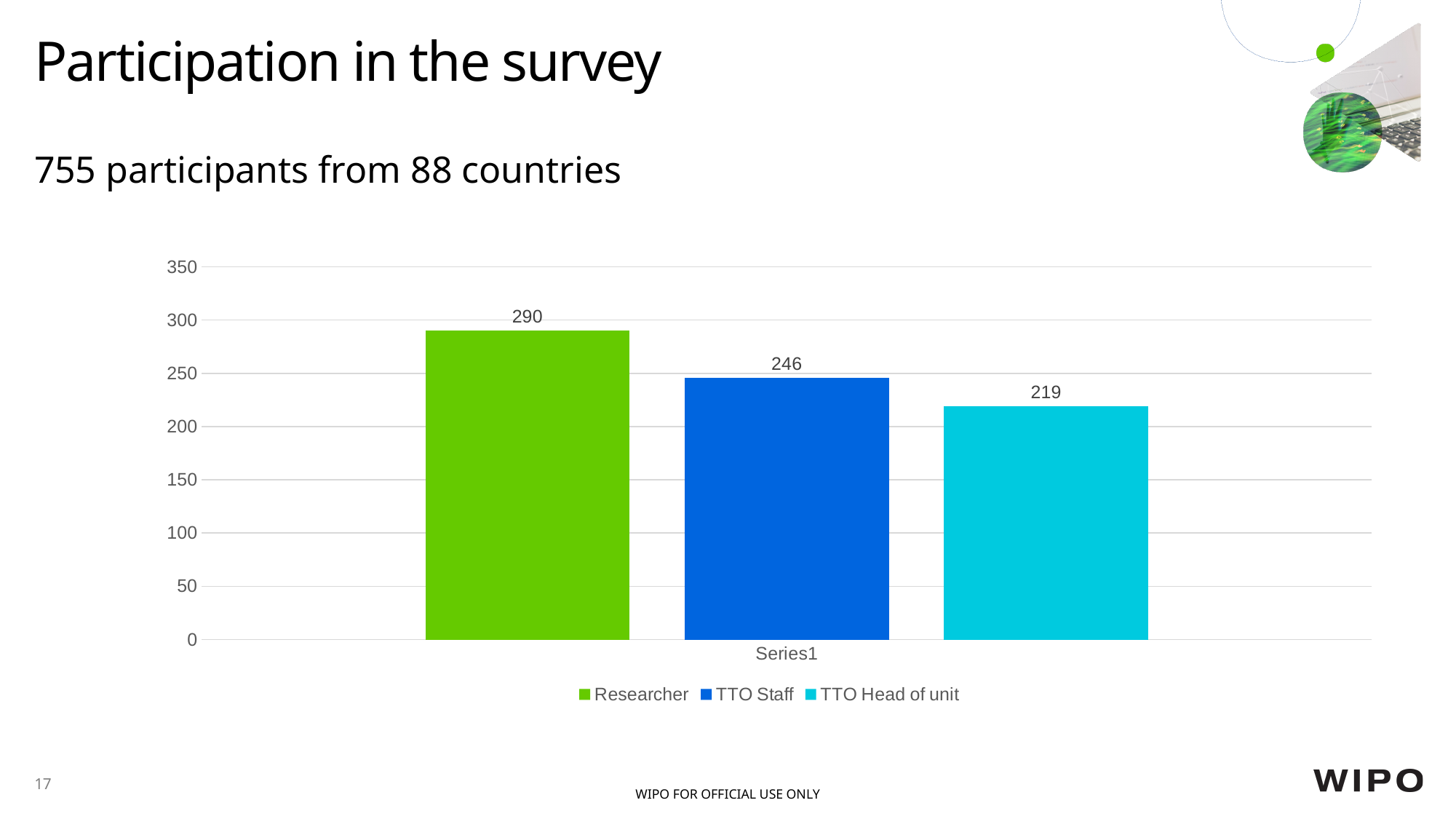
What is the difference between the TTO Staff and TTO Head of unit values? 27 What is the value for TTO Staff? 246 Which group has the highest value? Researcher What kind of chart is shown on the slide? bar chart Is the value for Researcher greater or less than 250? greater How many series does the legend list? 3 What colour is the bar for TTO Staff? blue What is the value for Researcher? 290 Which group has the lowest value? TTO Head of unit What is the value for TTO Head of unit? 219 What is the difference between the Researcher and TTO Staff values? 44 Which is larger, the value for TTO Staff or the value for TTO Head of unit? TTO Staff